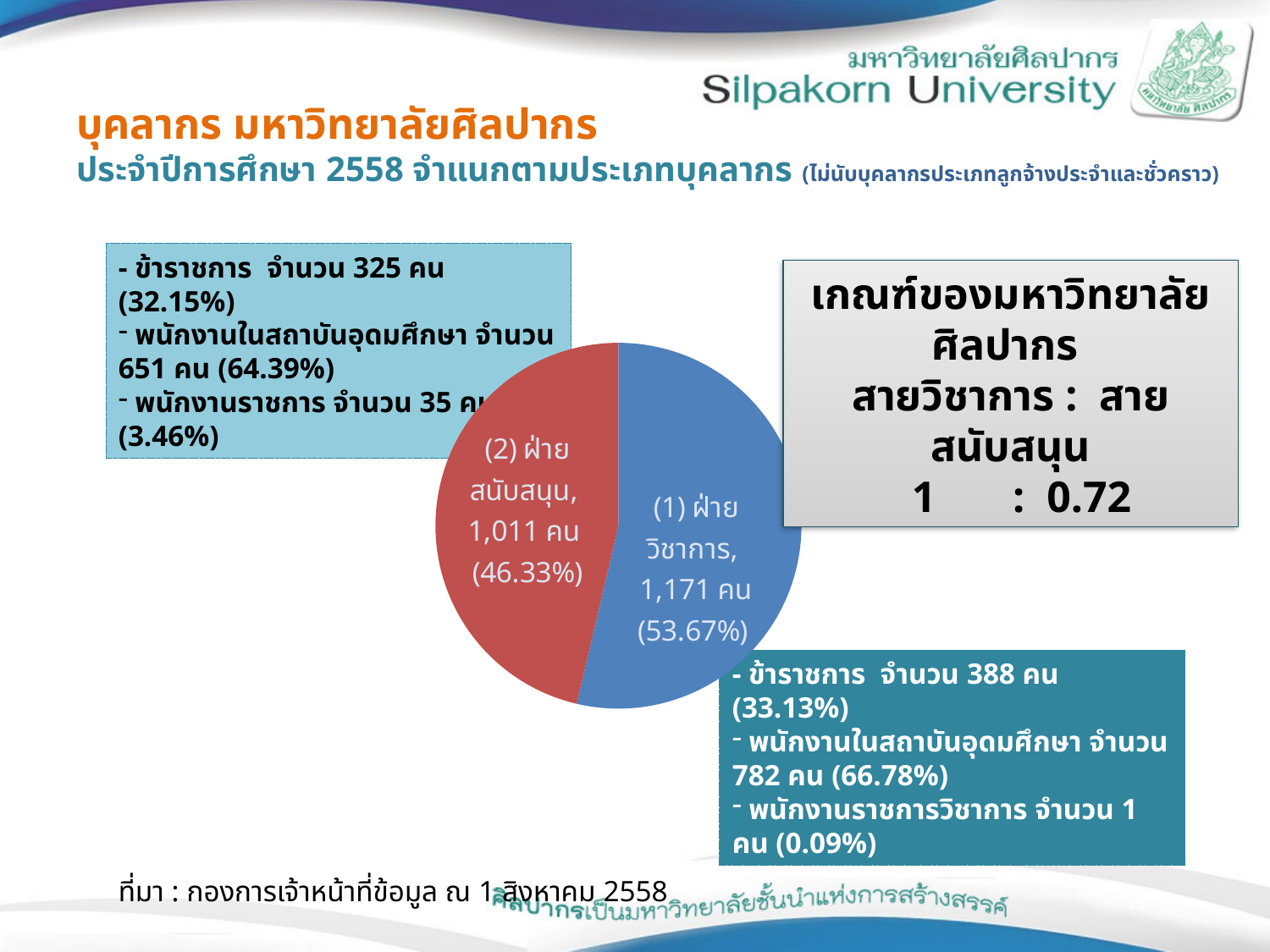
What kind of chart is shown on the slide? pie chart What share of the pie does the (1) ฝ่ายวิชาการ slice represent? 53.67% How many slices does the pie chart have? 2 What is the total headcount represented by the two slices of the pie chart? 2,182 คน How many people are in the (2) ฝ่ายสนับสนุน slice of the pie chart? 1,011 คน Which slice of the pie chart is the smallest? (2) ฝ่ายสนับสนุน What is the difference in headcount between the ฝ่ายวิชาการ and ฝ่ายสนับสนุน slices? 160 คน How many people are in the (1) ฝ่ายวิชาการ slice of the pie chart? 1,171 คน What colour is the (2) ฝ่ายสนับสนุน slice of the pie chart? red Which is larger in the pie chart, ฝ่ายวิชาการ or ฝ่ายสนับสนุน? ฝ่ายวิชาการ Which slice of the pie chart is the largest? (1) ฝ่ายวิชาการ What share of the pie does the (2) ฝ่ายสนับสนุน slice represent? 46.33%